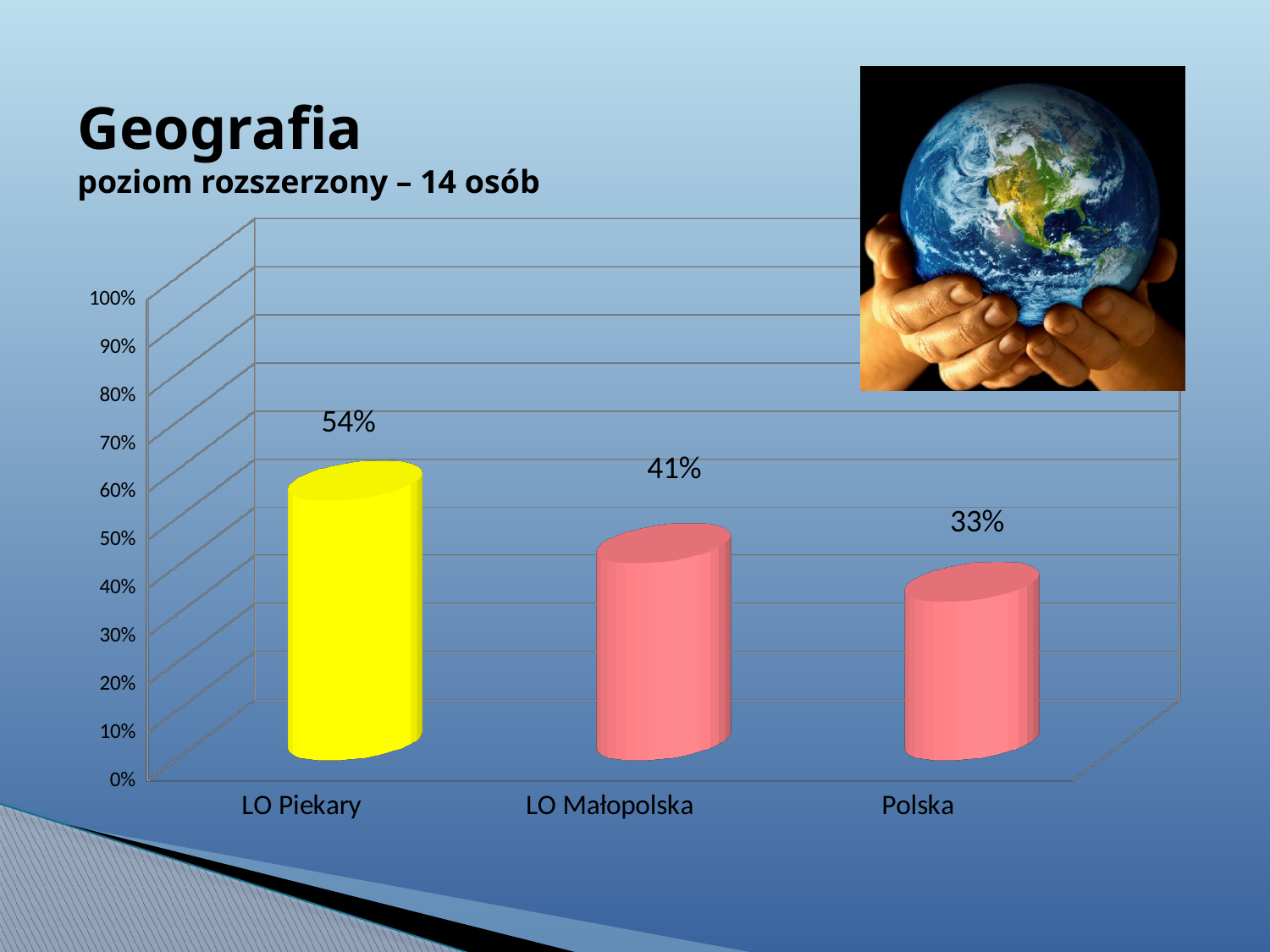
Which category has the lowest value? Polska What is the difference between the values for LO Piekary and LO Małopolska? 13% Which category has the highest value? LO Piekary What is the difference between the values for LO Piekary and Polska? 21% How many categories are shown on the chart? 3 What is the value for LO Piekary? 54% Is the value for LO Piekary greater or less than 50%? greater Which is larger, the value for LO Małopolska or the value for Polska? LO Małopolska What is the value for Polska? 33% What is the value for LO Małopolska? 41% What kind of chart is shown on the slide? bar chart Do the values rise or fall from left to right along the x axis? fall